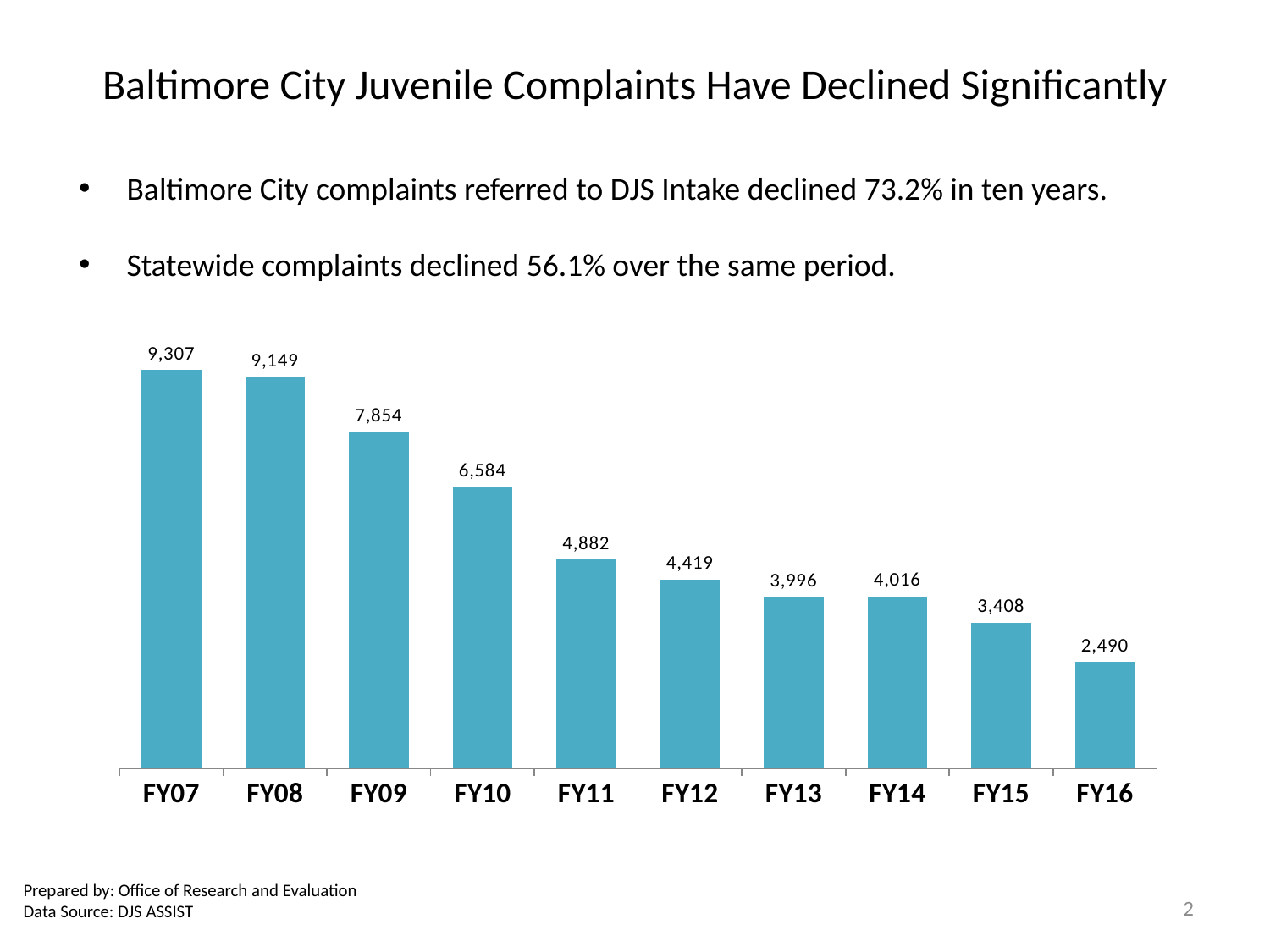
How many fiscal years are shown on the chart? 10 Which is larger, the value for FY13 or the value for FY14? FY14 What is the value for FY07? 9,307 What is the value for FY11? 4,882 What is the title of the slide containing the chart? Baltimore City Juvenile Complaints Have Declined Significantly What kind of chart is shown on the slide? bar chart Which fiscal year has the highest value? FY07 What is the difference between the values for FY09 and FY10? 1,270 Do the values generally rise or fall from FY07 to FY16? fall Which fiscal year has the lowest value? FY16 What is the difference between the values for FY07 and FY16? 6,817 What is the value for FY16? 2,490